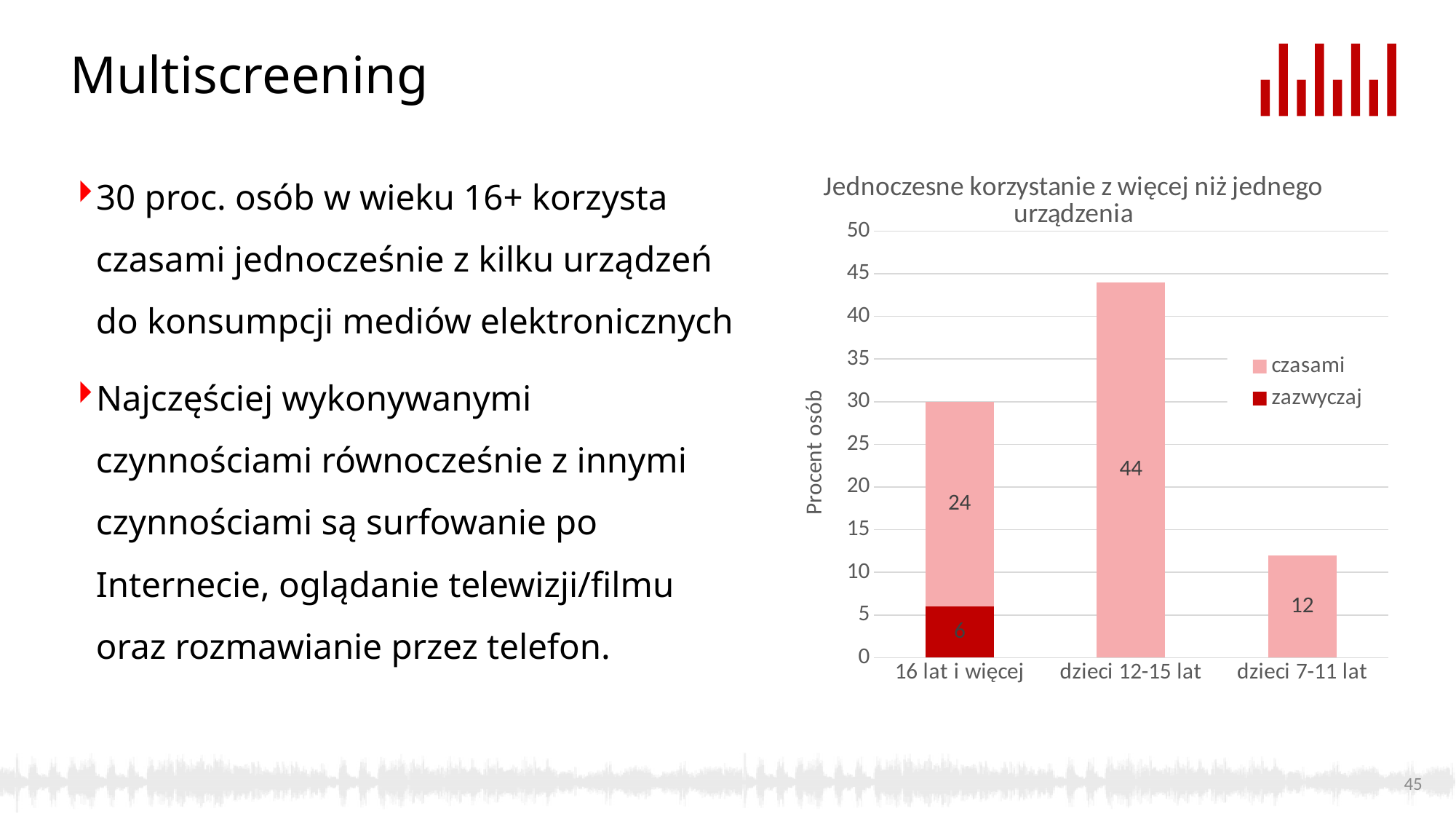
What is the total of the stacked bar for "16 lat i więcej"? 30 Which category has the highest "czasami" value? dzieci 12-15 lat What is the value of the "zazwyczaj" series for "16 lat i więcej"? 6 What is the value of the "czasami" series for "dzieci 12-15 lat"? 44 Which is larger: the "czasami" value for "16 lat i więcej" or for "dzieci 7-11 lat"? 16 lat i więcej How many series does the legend list? 2 How many categories are shown on the x axis? 3 What is the value of the "czasami" series for "dzieci 7-11 lat"? 12 What is the difference between the "czasami" values for "dzieci 12-15 lat" and "dzieci 7-11 lat"? 32 What is the value of the "czasami" series for "16 lat i więcej"? 24 Which category has the lowest "czasami" value? dzieci 7-11 lat What kind of chart is shown on the slide? Stacked bar chart